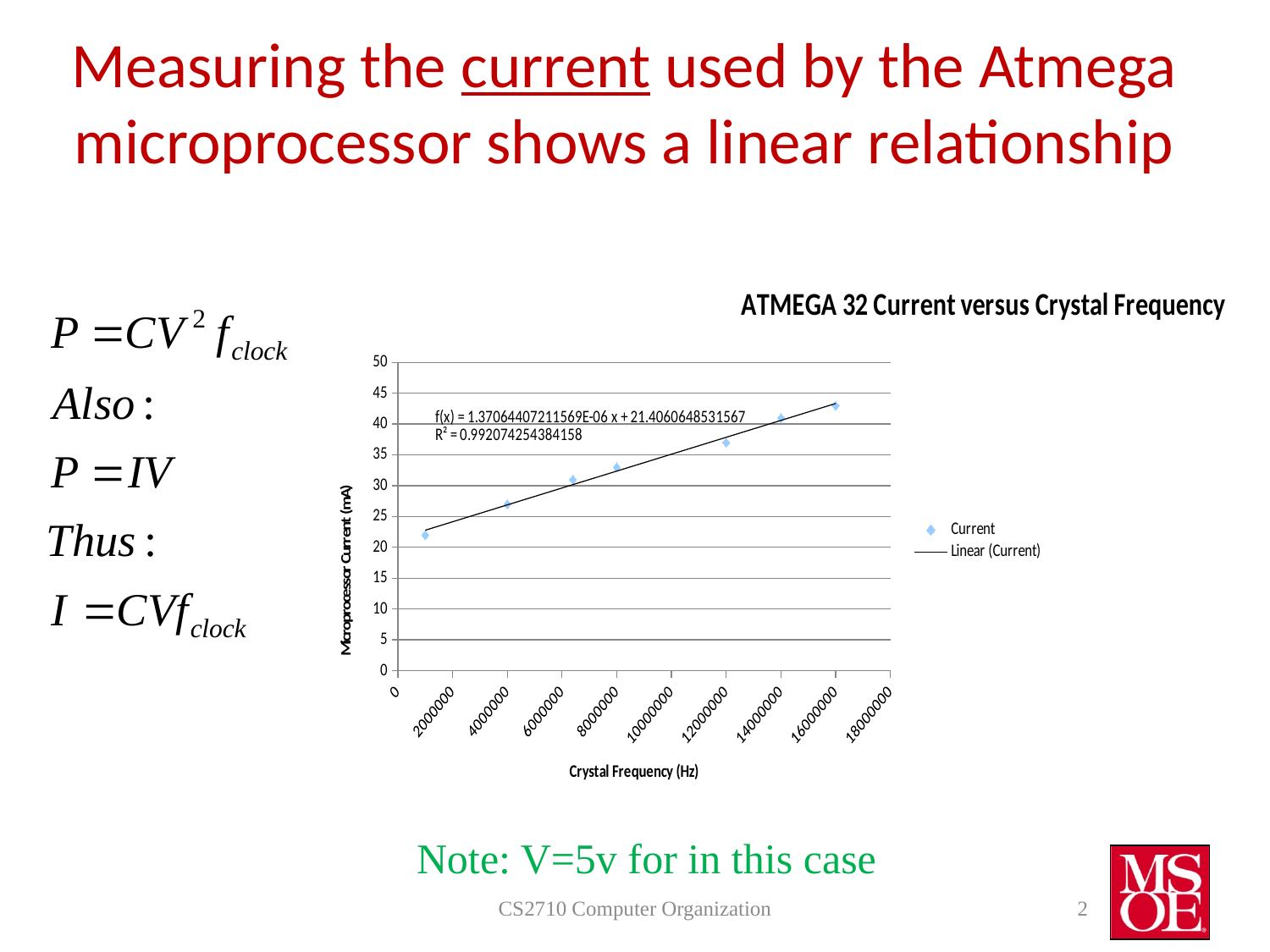
Which has the larger current: the point at 8000000 Hz or the point at 16000000 Hz? 16000000 Hz What is the R² value printed for the linear trendline? 0.992074254384158 What kind of chart is shown on the slide? scatter chart Is the current value at 8000000 Hz greater or less than 30 mA? greater Is the current value at 16000000 Hz greater or less than 40 mA? greater At which crystal frequency is the plotted current highest? 16000000 Hz How many data points are plotted for the Current series? 7 What is the title of the chart? ATMEGA 32 Current versus Crystal Frequency Is the current value for the leftmost data point greater or less than 25 mA? less Does the microprocessor current rise or fall as crystal frequency increases? rise How many series does the chart legend list? 2